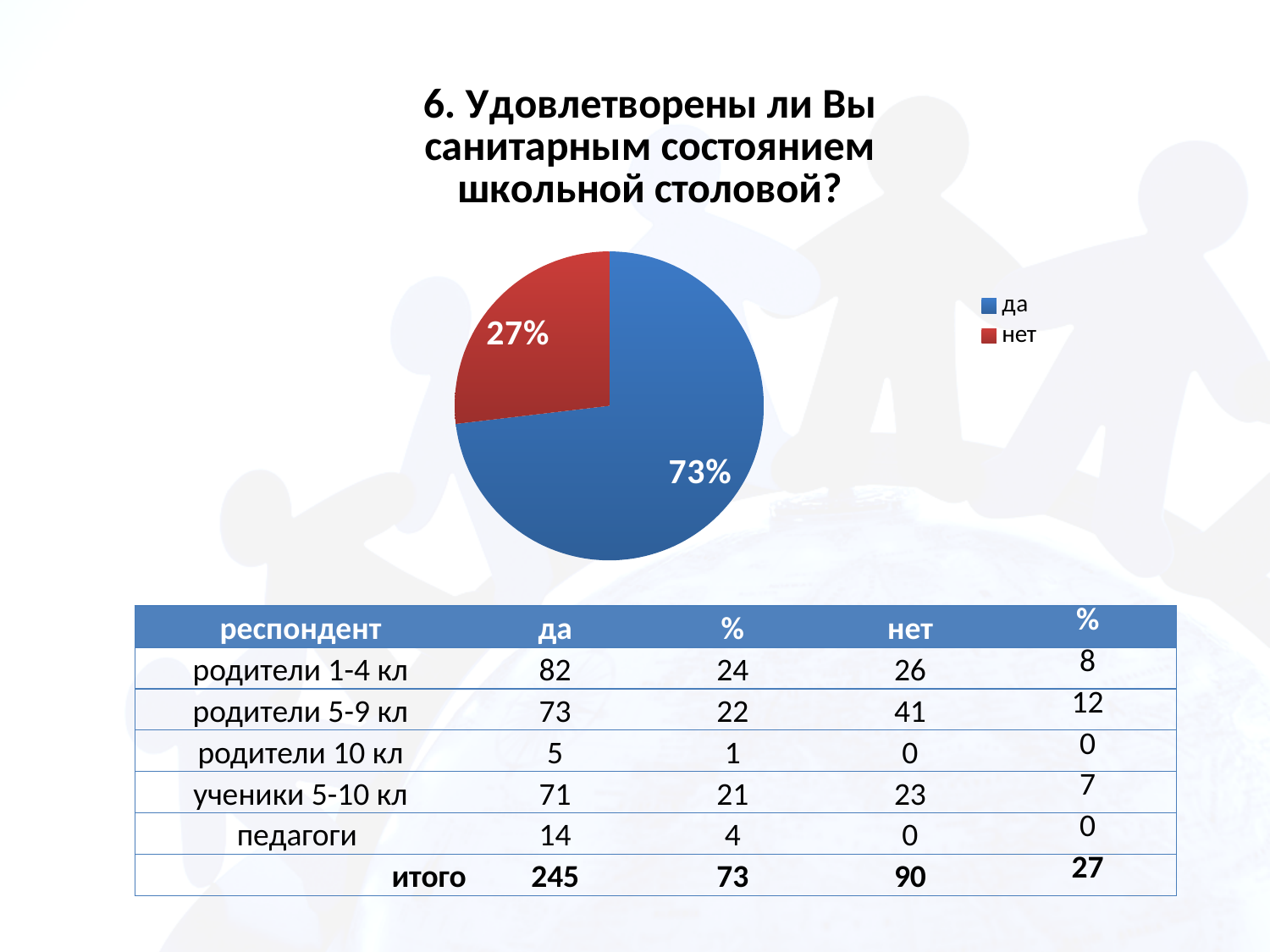
Which slice of the pie is the smallest? нет What colour is the "нет" slice in the pie chart? red What share of the pie does "нет" represent? 27% What kind of chart is shown on the slide? pie chart What share of the pie does "да" represent? 73% Which slice of the pie is the largest? да How many slices does the pie chart have? 2 What is the difference in percentage points between the "да" and "нет" slices? 46 Which is larger, the "да" slice or the "нет" slice? да What is the title of the chart? 6. Удовлетворены ли Вы санитарным состоянием школьной столовой? How many entries does the legend list? 2